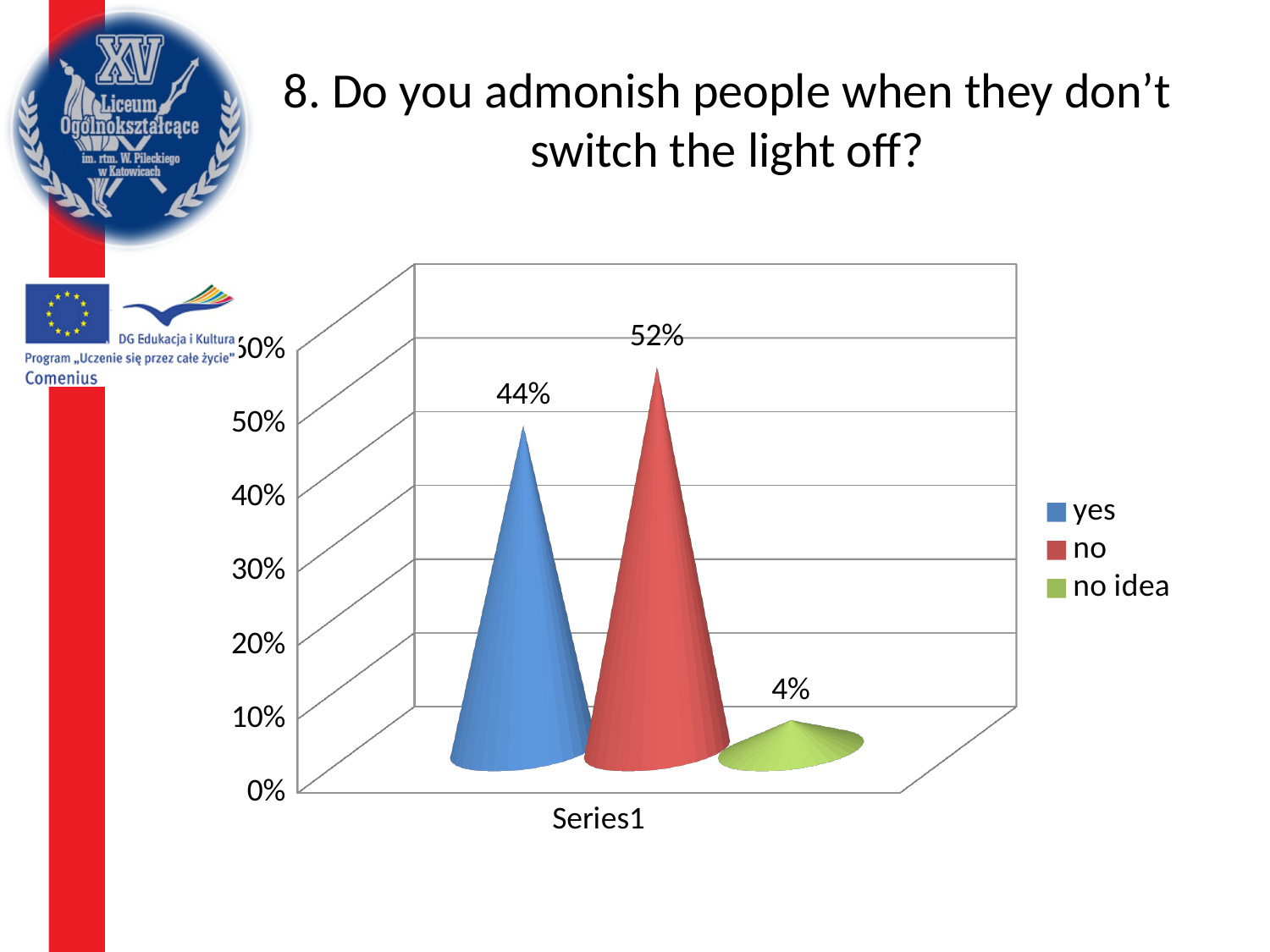
Which answer has the lowest percentage? no idea Which is larger, the percentage for "yes" or for "no"? no What percentage of respondents answered "no idea"? 4% What is the difference between the "yes" and "no idea" percentages? 40% How many entries does the legend list? 3 What is the difference between the "no" and "yes" percentages? 8% How many answer options are plotted in the chart? 3 What percentage of respondents answered "no"? 52% What colour represents the "no" answer in the chart? red What percentage of respondents answered "yes"? 44% Is the value for "yes" greater or less than 40%? greater Which answer has the highest percentage? no